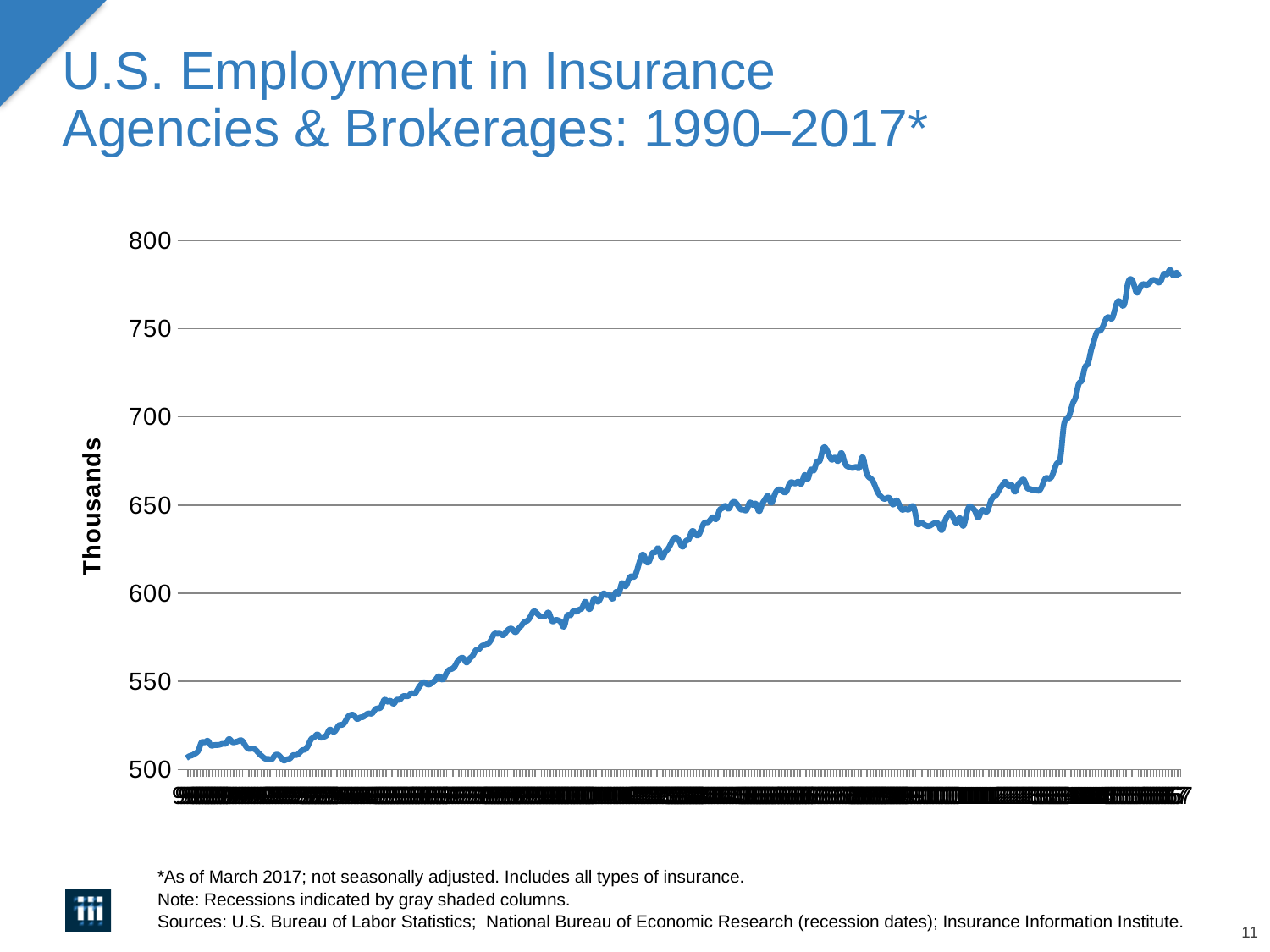
Is the value at the end of the series larger or smaller than the value at the start of the series? Larger Is the value at the start of the series (left end of the line) greater or less than 550? less Is the highest point reached by the line greater or less than 800? less What is the title of the slide? U.S. Employment in Insurance Agencies & Brokerages: 1990–2017* What is the label on the vertical axis? Thousands What kind of chart is shown on the slide? Line chart Overall, do the values rise or fall from the left of the x axis to the right? Rise Is the lowest point of the line greater or less than 500? greater